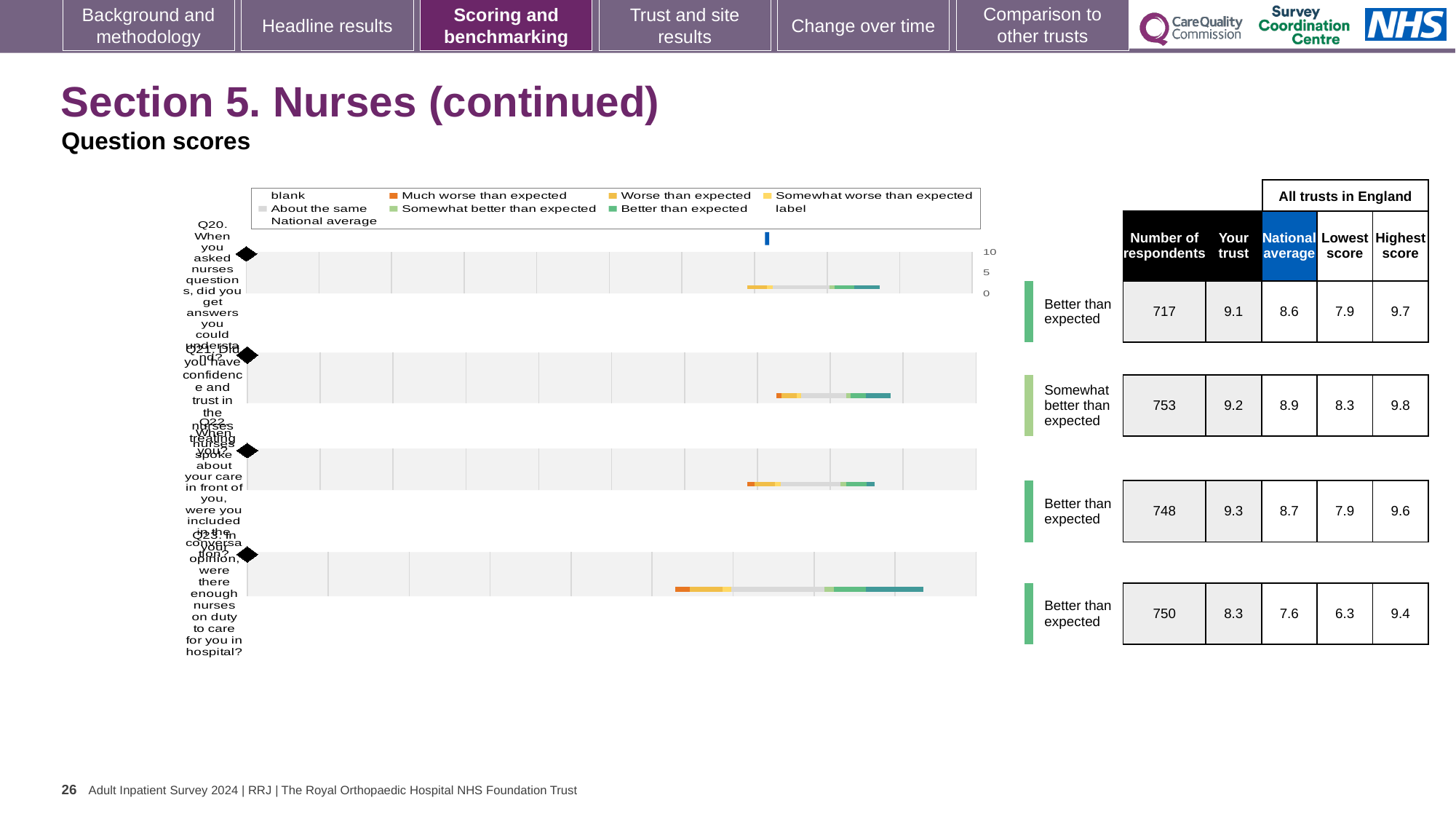
What kind of chart is shown on the slide? Bar chart How many respondents answered Q21 (Did you have confidence and trust in the nurses treating you?)? 753 What is the title of the slide containing the chart? Section 5. Nurses (continued) For Q21, which is larger: the 'Your trust' score or the national average? Your trust Which question has the lowest 'Your trust' score? Q23 How many questions (rows) are plotted in the chart? 4 What is the 'Your trust' score for Q20 (When you asked nurses questions, did you get answers you could understand?)? 9.1 What is the national average score for Q23 (were there enough nurses on duty to care for you in hospital?)? 7.6 What is the highest score among all trusts in England for Q22? 9.6 For Q23, what is the difference between the 'Your trust' score and the national average? 0.7 What benchmark category is shown for Q21? Somewhat better than expected Which question has the highest 'Your trust' score? Q22